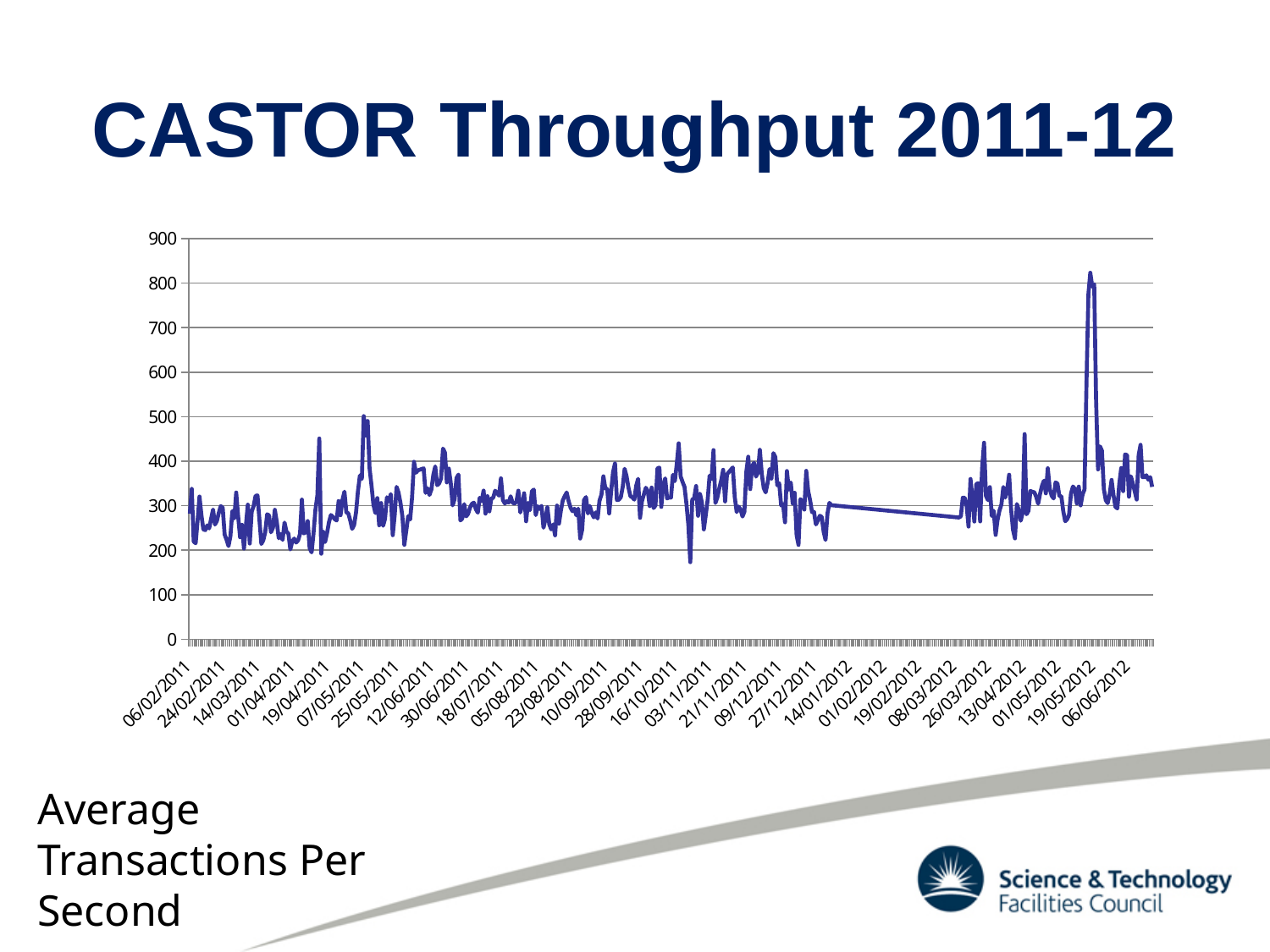
What quantity does the chart plot, according to the text on the slide? Average Transactions Per Second Is the value around 01/02/2012 greater or less than 400? less What is the title of the chart on the slide? CASTOR Throughput 2011-12 What is the highest value shown on the y axis? 900 What is the first date label on the x axis? 06/02/2011 Is the highest peak of the line greater or less than 700? greater Is the value around 01/02/2012 greater or less than 200? greater What kind of chart is shown on the slide? line chart How many date labels are shown along the x axis? 28 What is the last date label on the x axis? 06/06/2012 In which year does the highest peak of the line occur? 2012